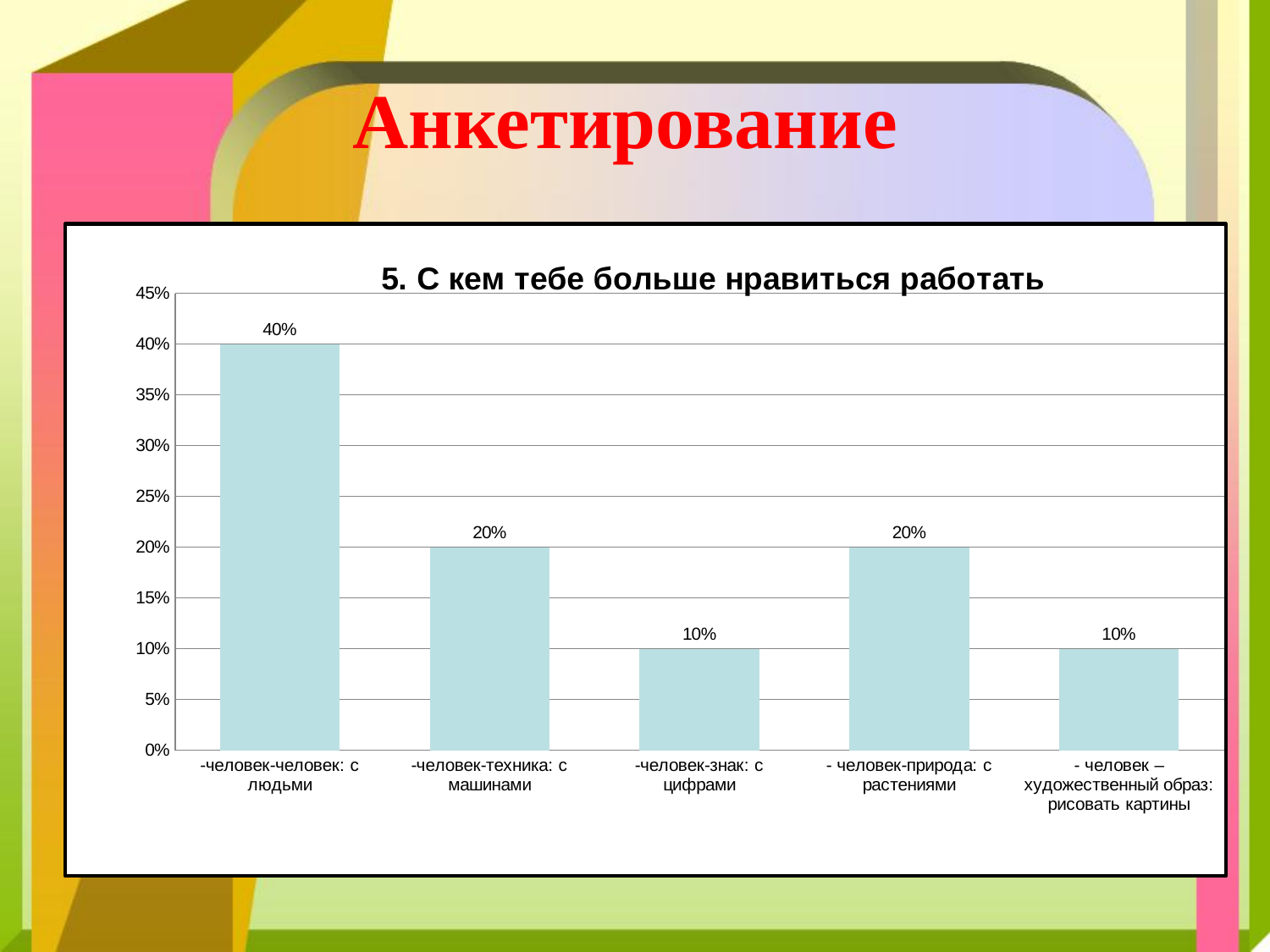
What is the value for the category "человек-человек: с людьми"? 40% What is the difference between the values for "человек-техника: с машинами" and "человек – художественный образ: рисовать картины"? 10% How many categories are shown on the x axis? 5 What is the value for the category "человек-знак: с цифрами"? 10% What is the difference between the values for "человек-человек: с людьми" and "человек-техника: с машинами"? 20% What is the highest value shown on the y axis? 45% Which category has the highest value? человек-человек: с людьми What is the title of the chart? 5. С кем тебе больше нравиться работать Which is larger, the value for "человек-природа: с растениями" or the value for "человек-знак: с цифрами"? человек-природа: с растениями What is the value for the category "человек-техника: с машинами"? 20% What is the value for the category "человек-природа: с растениями"? 20% What kind of chart is shown on the slide? bar chart